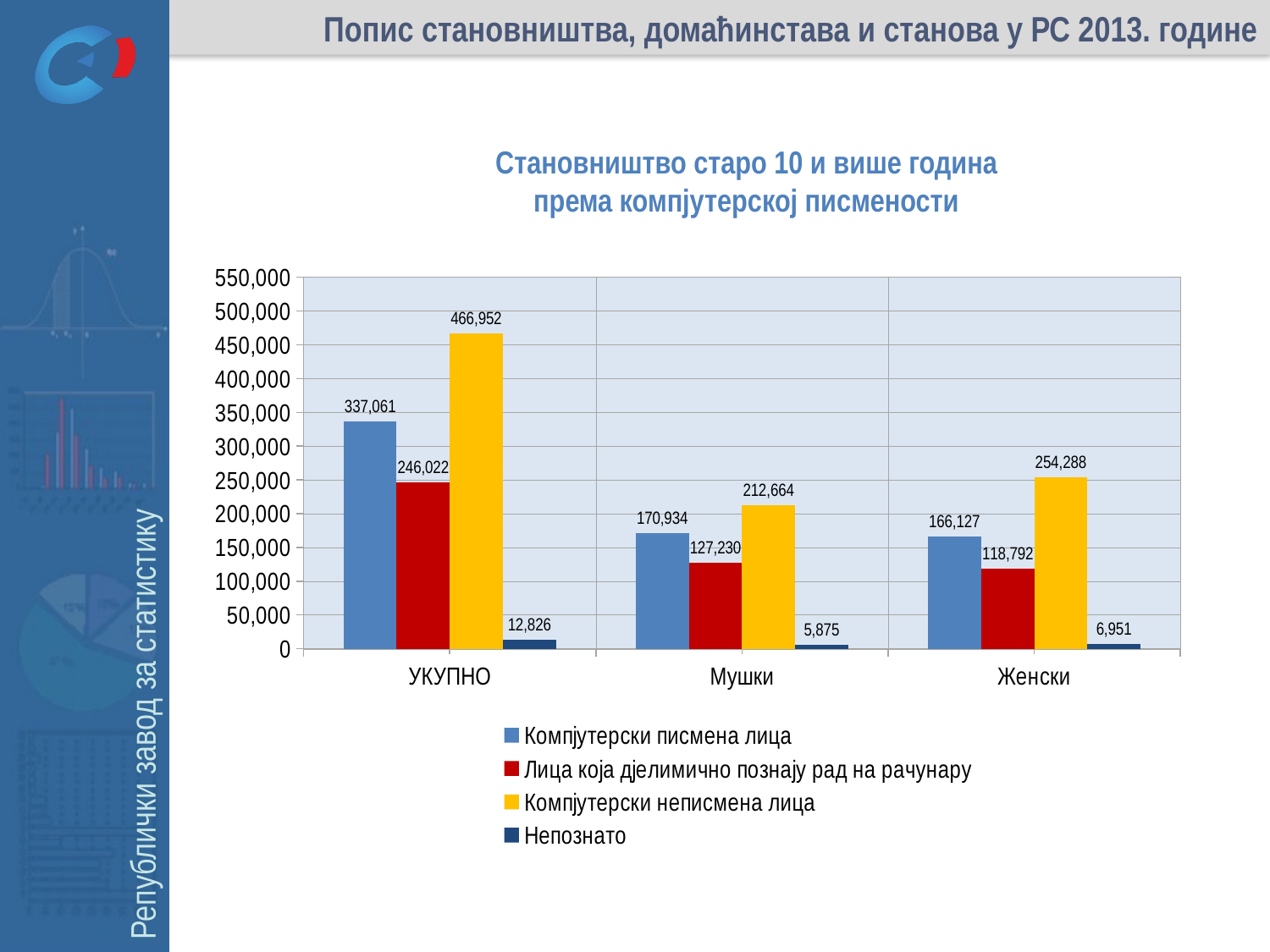
What kind of chart is shown on the slide? bar chart Which series has the highest value in the УКУПНО category? Компјутерски неписмена лица What is the value for Лица која дјелимично познају рад на рачунару in the Женски category? 118,792 What is the value for Непознато in the Мушки category? 5,875 Which series has the lowest value in the Женски category? Непознато Is the value for Компјутерски неписмена лица in the УКУПНО category greater or less than 450,000? greater What is the difference between Компјутерски неписмена лица and Компјутерски писмена лица in the Мушки category? 41,730 How many categories are shown on the x axis? 3 What is the value for Компјутерски писмена лица in the УКУПНО category? 337,061 Which is larger: Компјутерски писмена лица for Мушки or for Женски? Мушки What is the value for Компјутерски неписмена лица in the Женски category? 254,288 How many series does the legend list? 4